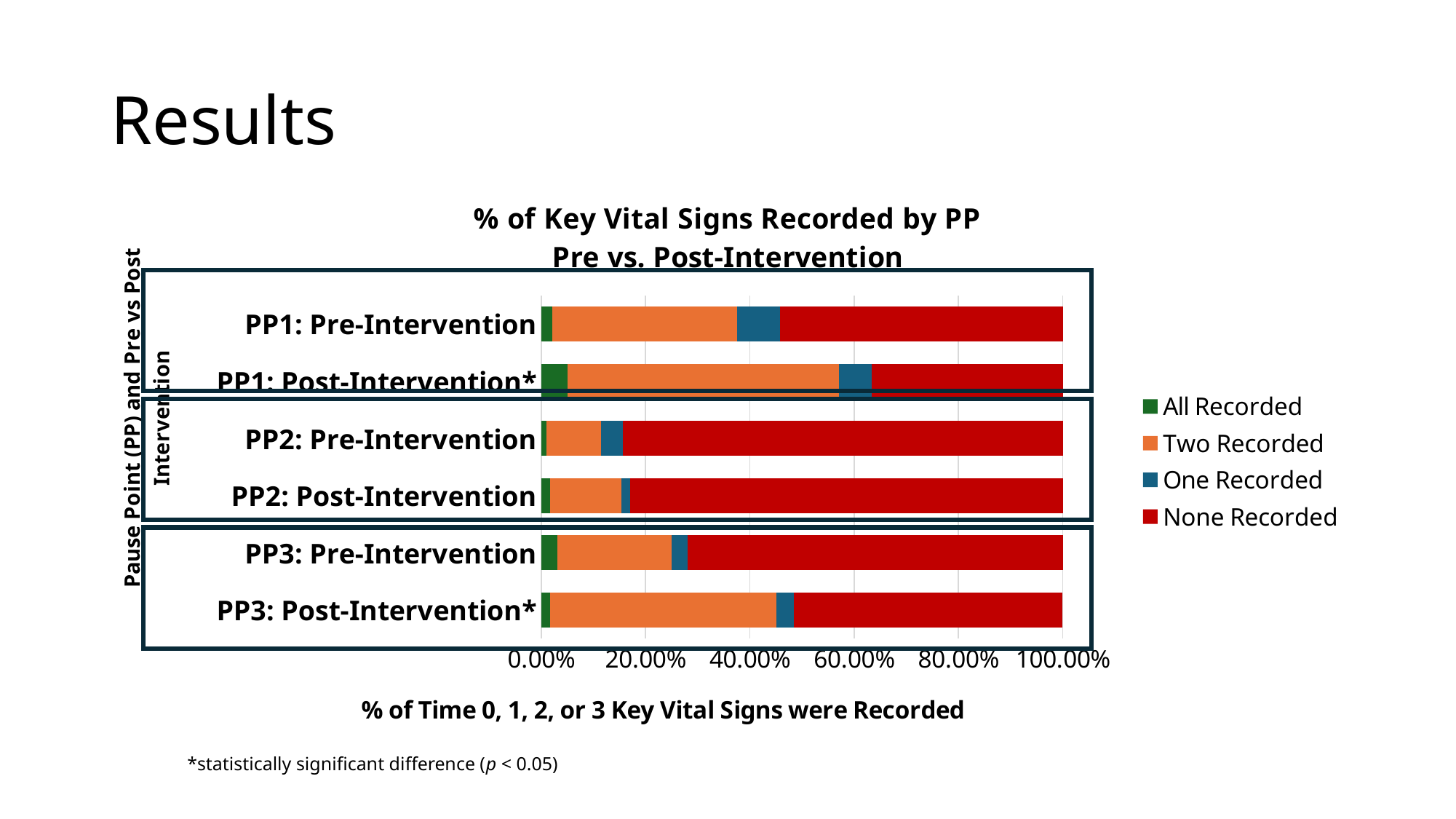
What type of chart is shown on the slide? Bar chart Is the None Recorded value for PP1: Post-Intervention* greater or less than 60.00%? less How many categories (bars) are plotted in the chart? 6 Which category has the smallest None Recorded segment? PP1: Post-Intervention* Which colour represents the None Recorded series in the legend? Red Is the None Recorded value for PP2: Pre-Intervention greater or less than 80.00%? greater What is the title of the chart? % of Key Vital Signs Recorded by PP Pre vs. Post-Intervention Which category has the largest Two Recorded segment? PP1: Post-Intervention* How many series does the legend list? 4 Is the Two Recorded segment larger for PP1: Pre-Intervention or PP1: Post-Intervention*? PP1: Post-Intervention* Which category has the largest All Recorded segment? PP1: Post-Intervention* Is the None Recorded segment larger for PP2: Pre-Intervention or PP3: Post-Intervention*? PP2: Pre-Intervention